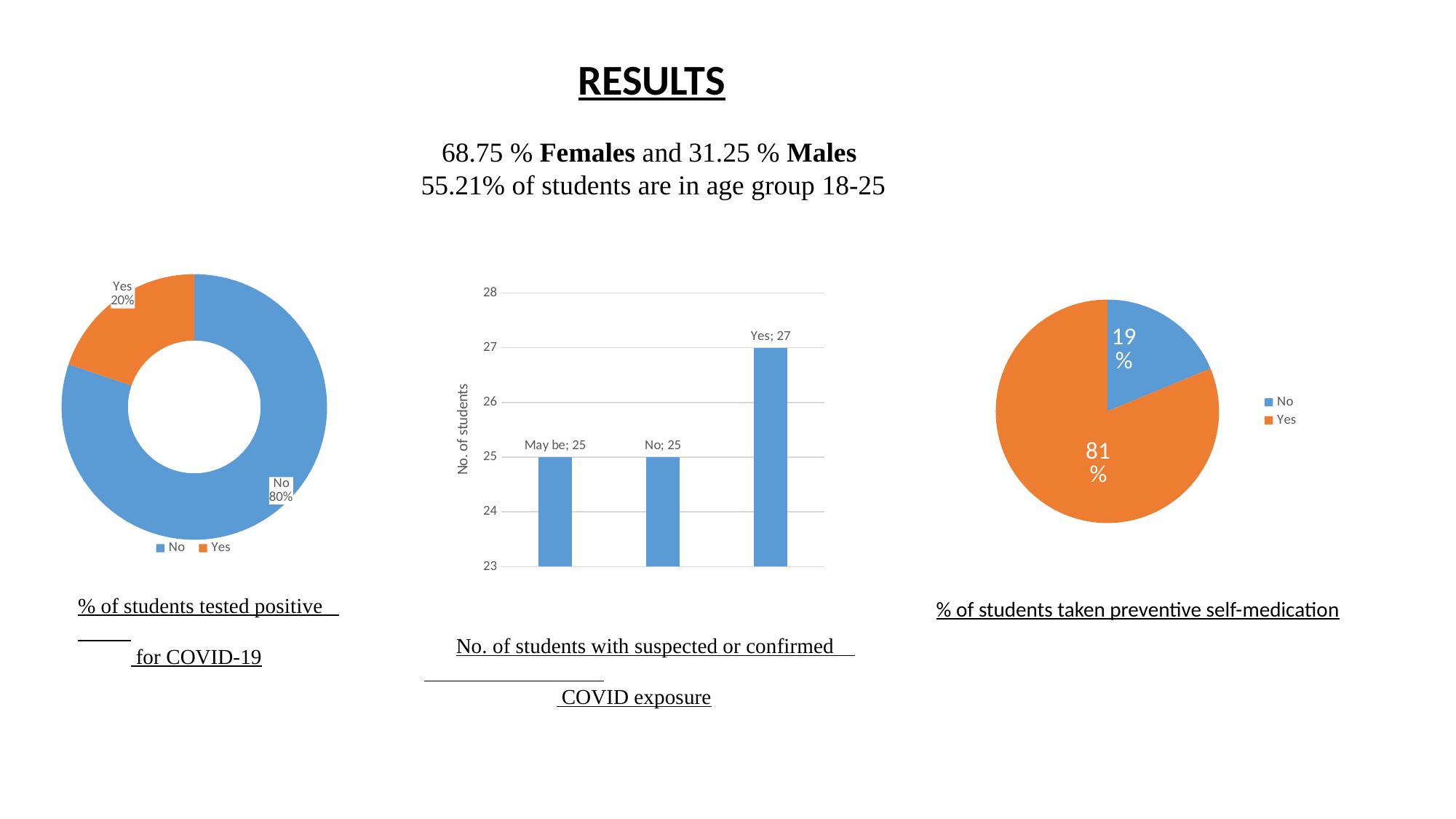
How many categories are shown in the 'No. of students with suspected or confirmed COVID exposure' chart? 3 In the 'No. of students with suspected or confirmed COVID exposure' chart, how many students answered May be? 25 In the '% of students taken preventive self-medication' chart, what percentage of students answered Yes? 81% In the '% of students taken preventive self-medication' chart, which slice is larger, No or Yes? Yes What kind of chart is the 'No. of students with suspected or confirmed COVID exposure' chart? Bar chart In the 'No. of students with suspected or confirmed COVID exposure' chart, what is the difference between the Yes and No values? 2 In the 'No. of students with suspected or confirmed COVID exposure' chart, which category has the highest number of students? Yes In the '% of students tested positive for COVID-19' chart, what percentage of students answered Yes? 20% What is the y-axis label of the 'No. of students with suspected or confirmed COVID exposure' chart? No. of students In the '% of students tested positive for COVID-19' chart, what percentage of students answered No? 80% In the 'No. of students with suspected or confirmed COVID exposure' chart, how many students answered Yes? 27 What kind of chart is the '% of students tested positive for COVID-19' chart? Doughnut chart